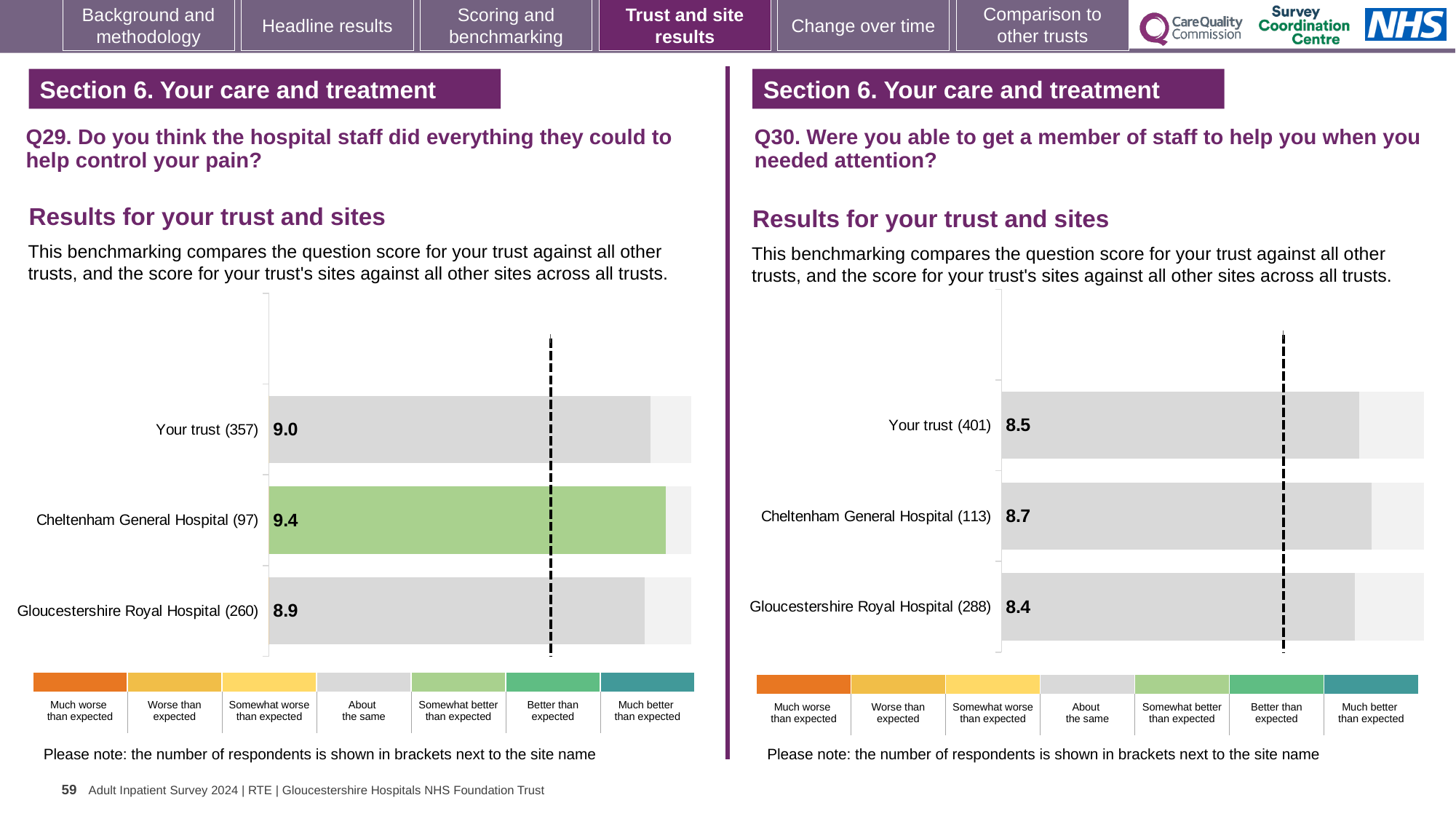
In the Q29 chart on the left, what is the score for Cheltenham General Hospital? 9.4 In the Q29 chart on the left, which site or trust has the highest score? Cheltenham General Hospital In the Q30 chart on the right, what is the score for Cheltenham General Hospital? 8.7 In the Q29 chart on the left, how many bars are plotted? 3 In the Q30 chart on the right, what is the difference between the scores for Cheltenham General Hospital and Your trust? 0.2 In the Q29 chart on the left, what is the score for Gloucestershire Royal Hospital? 8.9 In the Q30 chart on the right, which site or trust has the lowest score? Gloucestershire Royal Hospital In the Q29 chart on the left, what is the difference between the scores for Cheltenham General Hospital and Gloucestershire Royal Hospital? 0.5 What kind of chart is used in the Q29 chart on the left? Bar chart In the Q30 chart on the right, what is the score for Your trust? 8.5 In the Q29 chart on the left, what is the score for Your trust? 9.0 In the Q30 chart on the right, what is the score for Gloucestershire Royal Hospital? 8.4